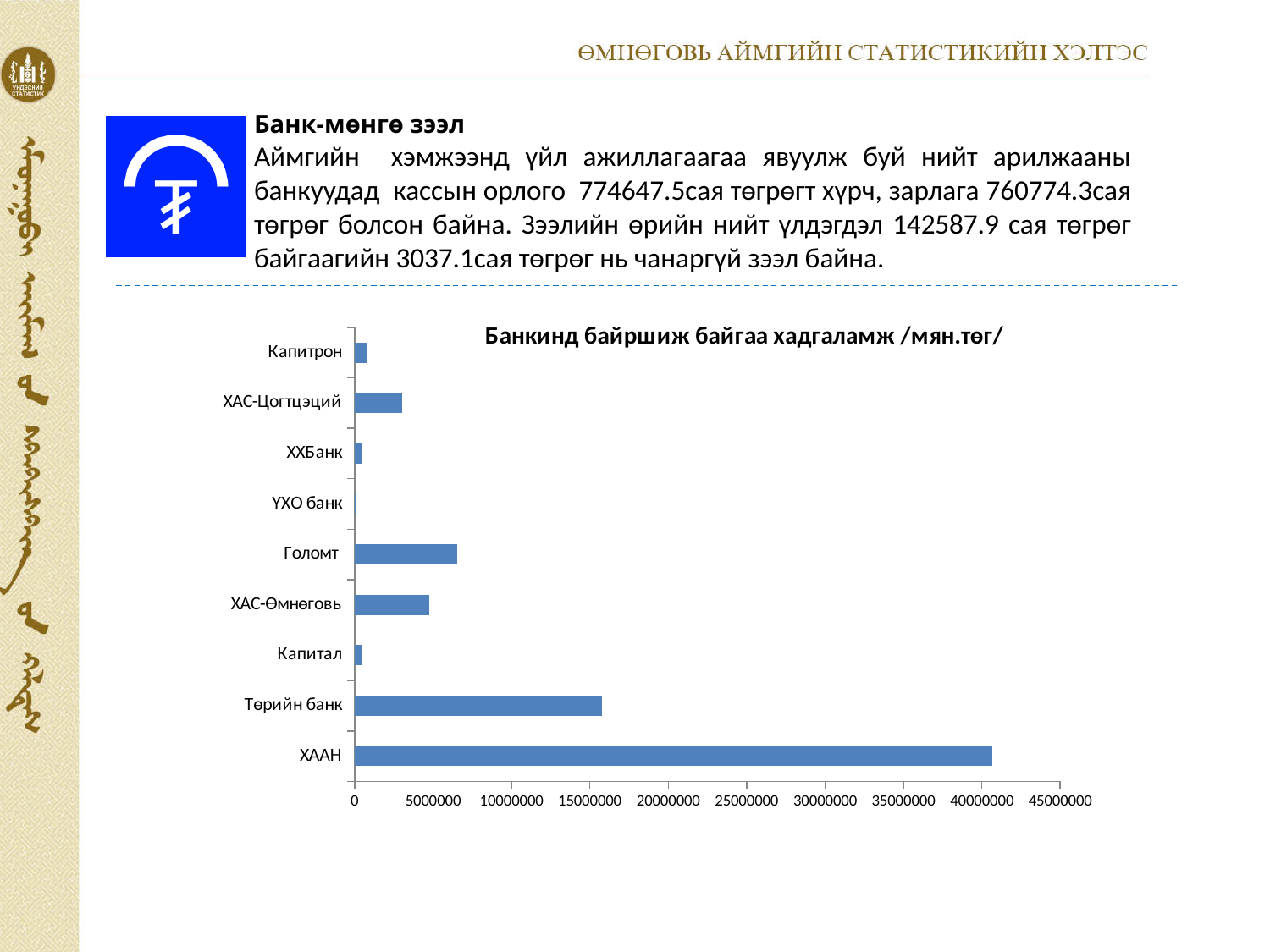
What colour are the bars in the chart? Blue Is the value for ХААН greater or less than 35000000? greater Which bank has the lowest value in the chart? ҮХО банк Which bank has the highest value in the chart? ХААН Which is larger, the value for Голомт or the value for ХАС-Өмнөговь? Голомт Is the value for ХАС-Цогтцэций greater or less than 5000000? less Is the value for Төрийн банк greater or less than 20000000? less Which is larger, the value for Төрийн банк or the value for Голомт? Төрийн банк What is the title of the chart? Банкинд байршиж байгаа хадгаламж /мян.төг/ How many banks are listed as categories in the chart? 9 What kind of chart is shown on the slide? Bar chart